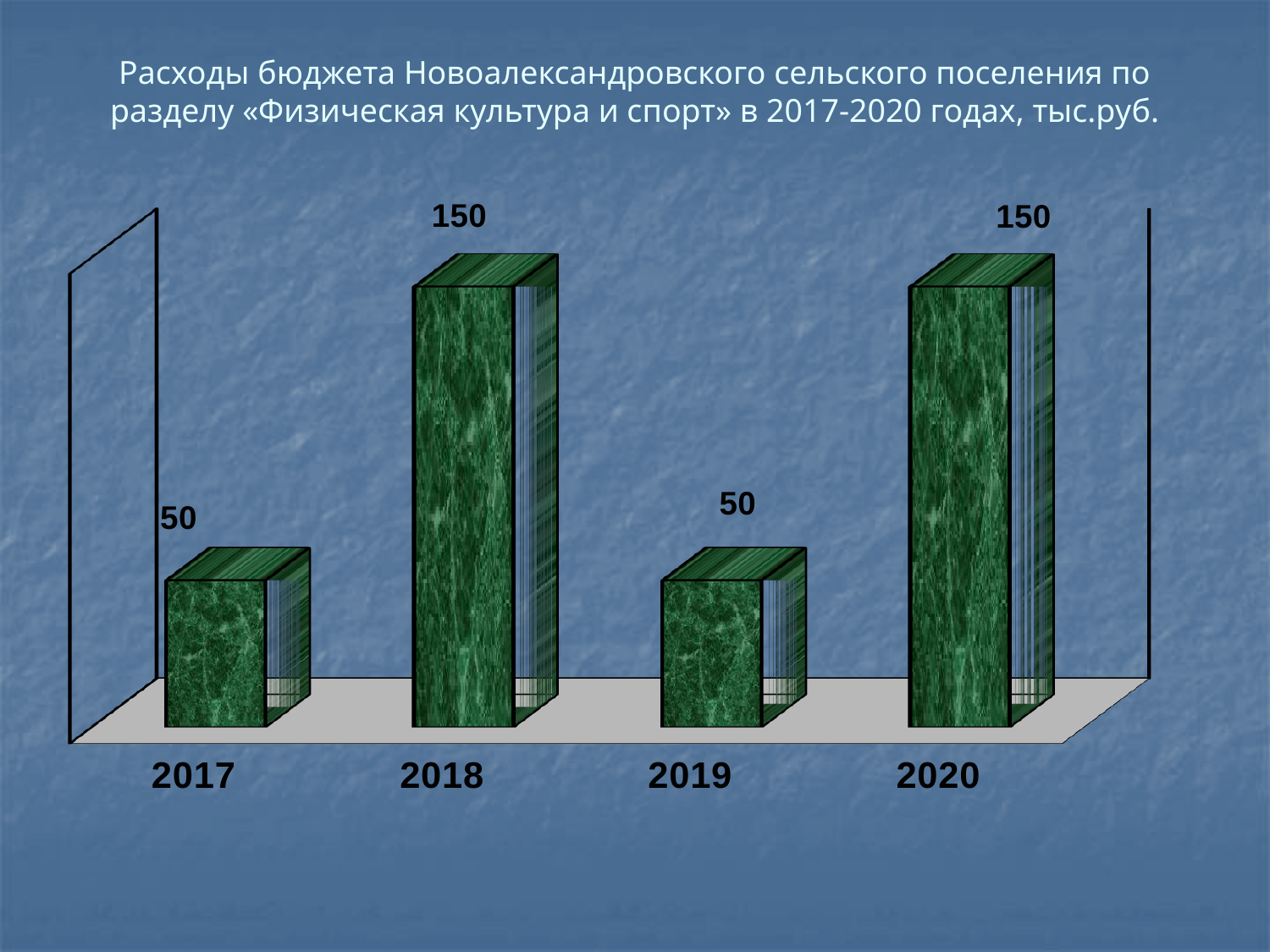
What is the value for 2019? 50 Which years share the lowest value on the chart? 2017 and 2019 How many years are shown on the chart? 4 What kind of chart is shown on the slide? Bar chart What is the value for 2017? 50 What is the value for 2018? 150 Does the value rise or fall from 2017 to 2018? Rise What is the value for 2020? 150 In what units are the values on the chart expressed, according to the title? тыс.руб. What is the difference between the values for 2018 and 2017? 100 Which years share the highest value on the chart? 2018 and 2020 Which is larger, the value for 2019 or the value for 2020? 2020